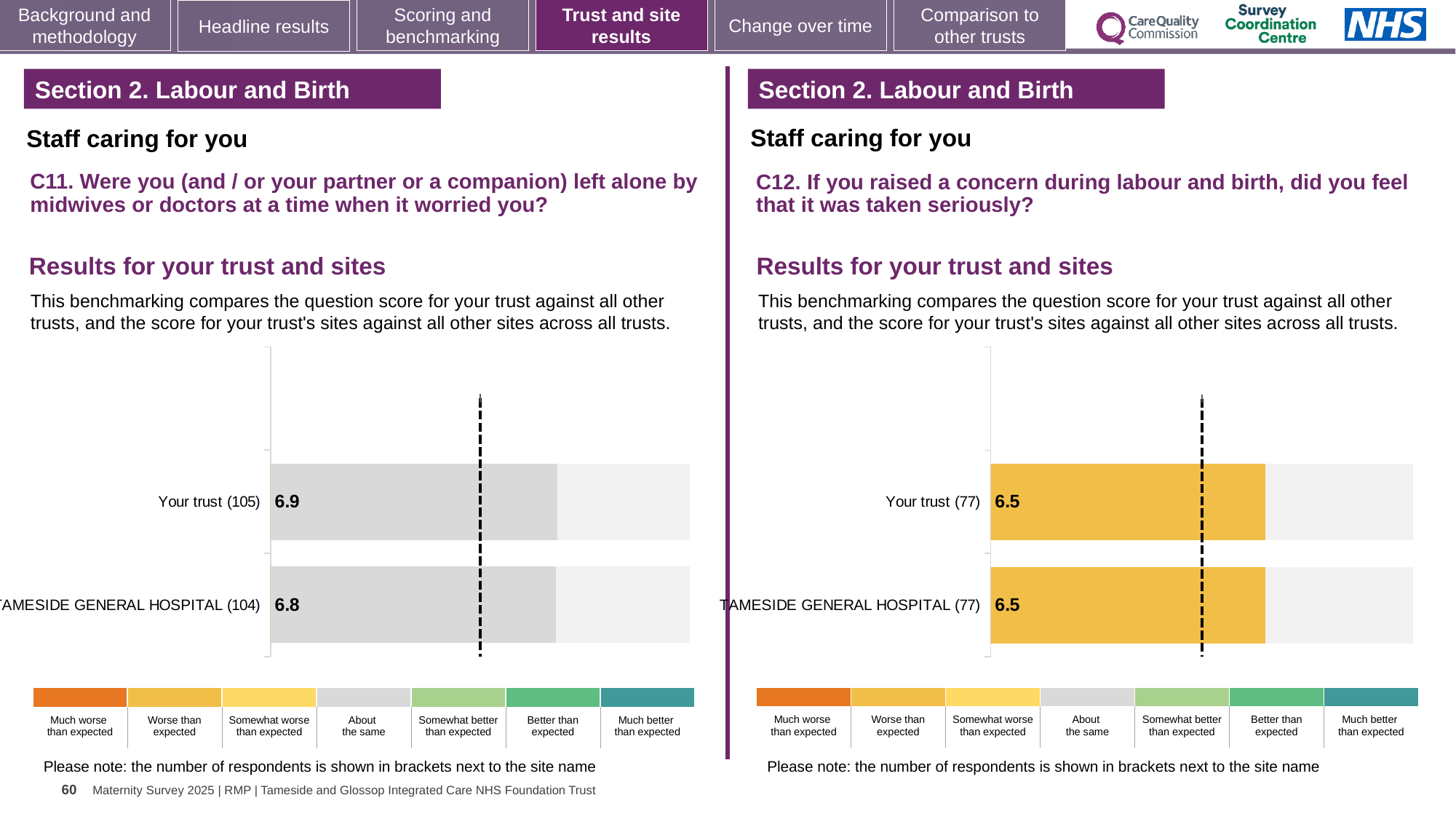
In the C12 chart on the right, what is the score for Tameside General Hospital? 6.5 According to the colour legend, which benchmark category do the bars in the C11 chart on the left fall into? About the same In the C12 chart on the right, how many respondents are shown in brackets for Tameside General Hospital? 77 In the C11 chart on the left, which has the higher score, Your trust or Tameside General Hospital? Your trust In the C12 chart on the right, what is the score for Your trust? 6.5 In the C11 chart on the left, what is the difference between the Your trust score and the Tameside General Hospital score? 0.1 How many benchmark categories does the colour legend below the C12 chart on the right list? 7 In the C11 chart on the left, how many respondents are shown in brackets for Your trust? 105 In the C11 chart on the left, what is the score for Tameside General Hospital? 6.8 What type of chart is used in the C11 chart on the left? Bar chart In the C11 chart on the left, what is the score for Your trust? 6.9 How many bars are plotted in the C12 chart on the right? 2